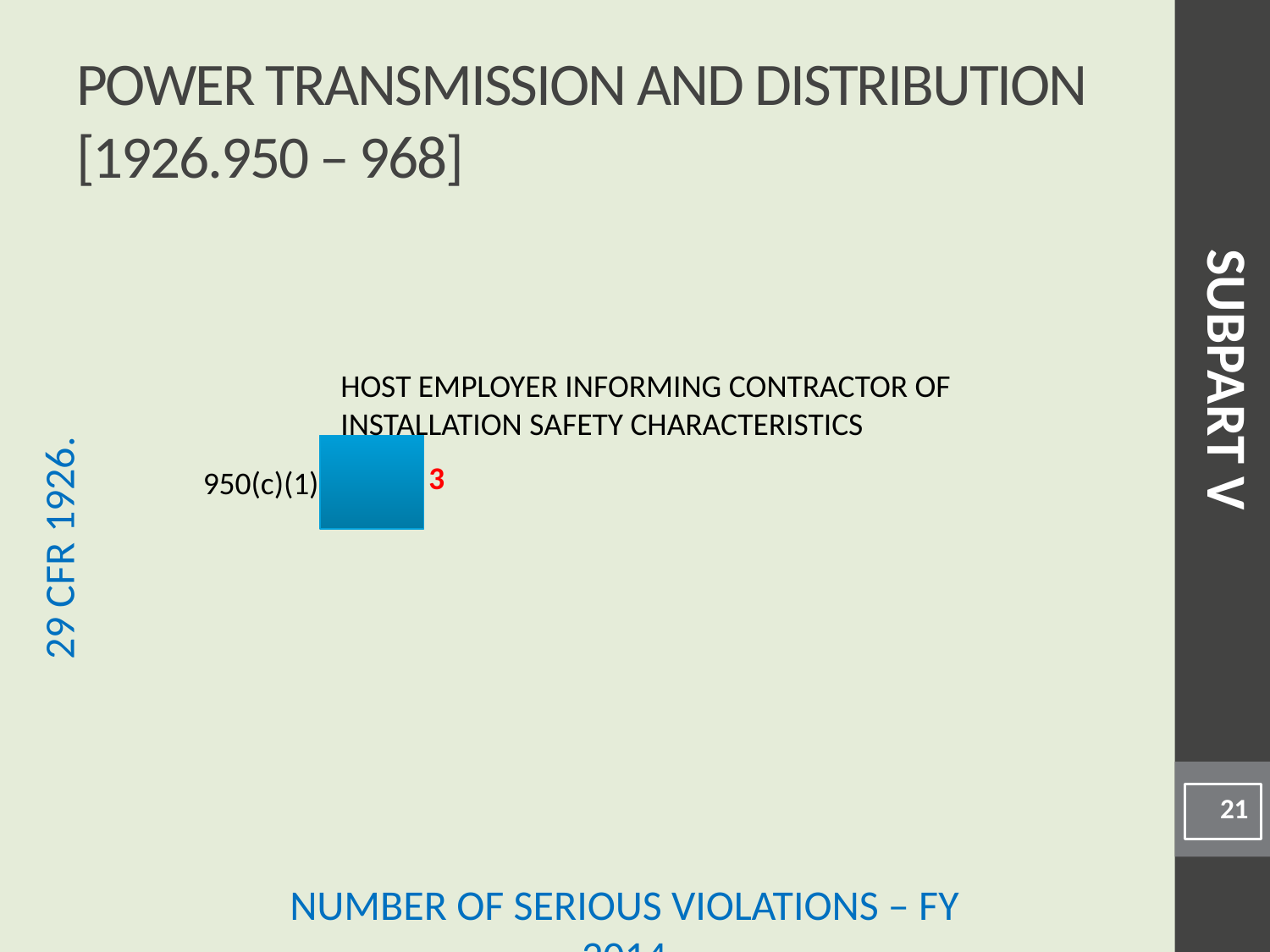
What is the value shown for 950(c)(1)? 3 What kind of chart is shown on the slide? bar chart What is the total number of serious violations shown in the chart? 3 What label is printed next to the bar for 950(c)(1)? 3 What colour is the bar in the chart? blue Which category has the highest value in the chart? 950(c)(1) How many categories are plotted in the chart? 1 What description is shown above the bar for 950(c)(1)? HOST EMPLOYER INFORMING CONTRACTOR OF INSTALLATION SAFETY CHARACTERISTICS